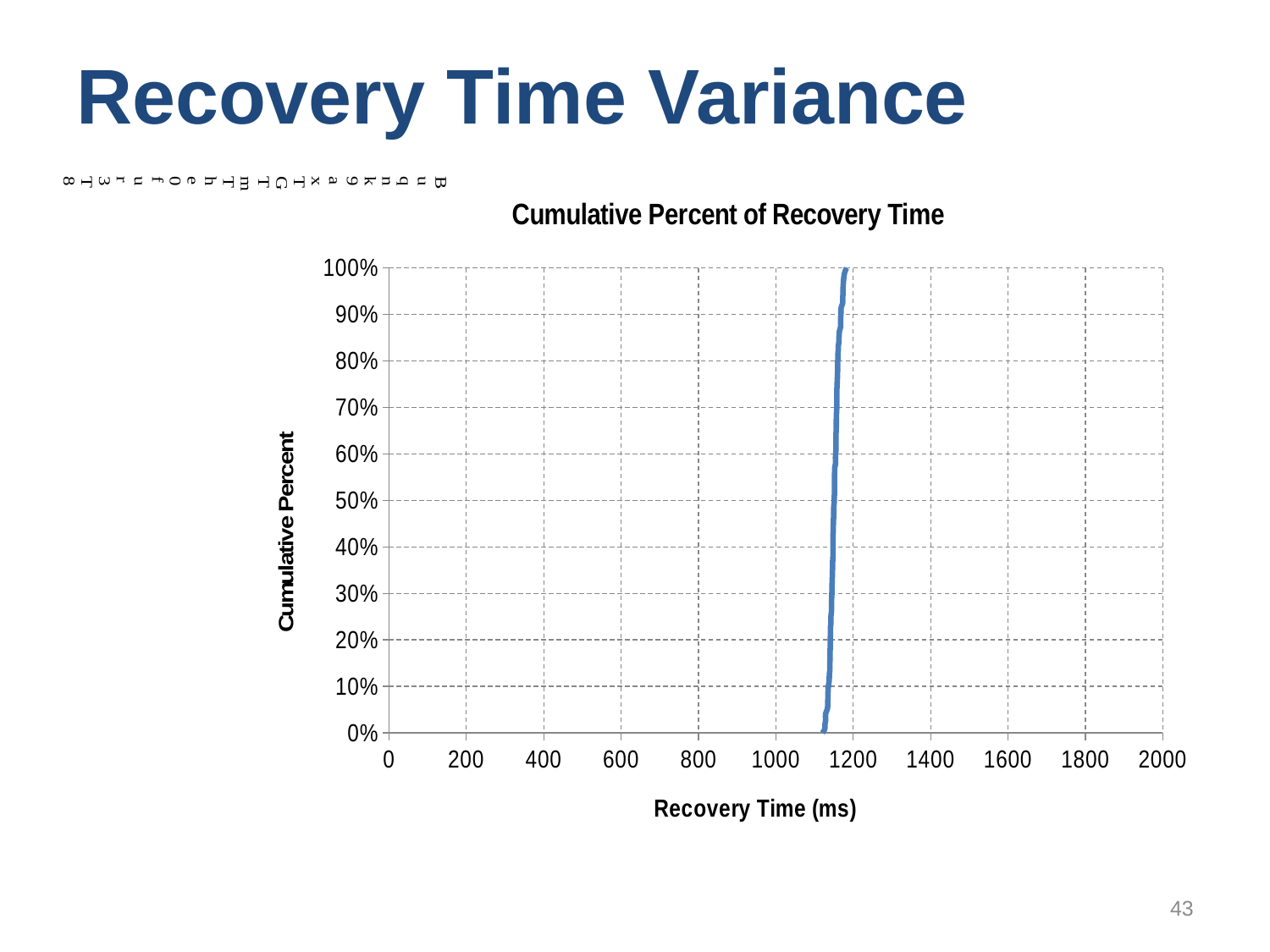
Is the recovery time at which the cumulative percent reaches 50% greater or less than 1000 ms? greater What kind of chart is shown on the slide? line chart Is the recovery time at which the cumulative percent reaches 90% greater or less than 1600 ms? less Is the recovery time at which the cumulative percent reaches 100% greater or less than 800 ms? greater What is the label of the x axis of the chart? Recovery Time (ms) Does the cumulative percent rise or fall as recovery time increases along the x axis? rise What is the title of the chart? Cumulative Percent of Recovery Time